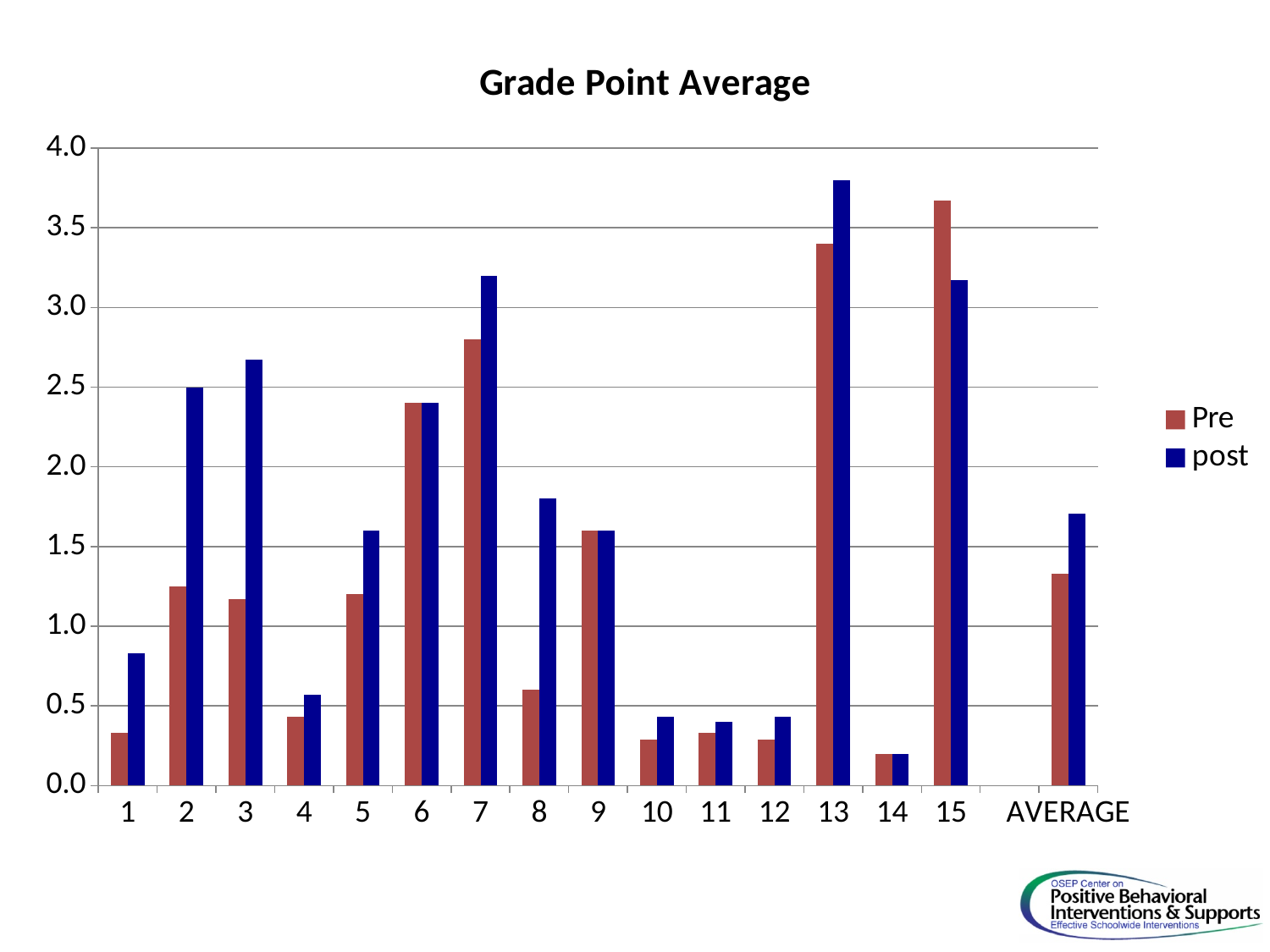
For category 2, which is larger, the Pre value or the post value? post What kind of chart is shown on the slide? bar chart For category 15, which is larger, the Pre value or the post value? Pre How many categories are shown along the x axis, including AVERAGE? 16 What is the title of the chart? Grade Point Average How many series does the legend list? 2 Which category has the highest post value? 13 Is the Pre value for category 15 greater or less than 3.5? greater Which category has the lowest post value? 14 Is the post value for AVERAGE greater or less than 1.5? greater What are the two series named in the legend? Pre and post Which category has the highest Pre value? 15